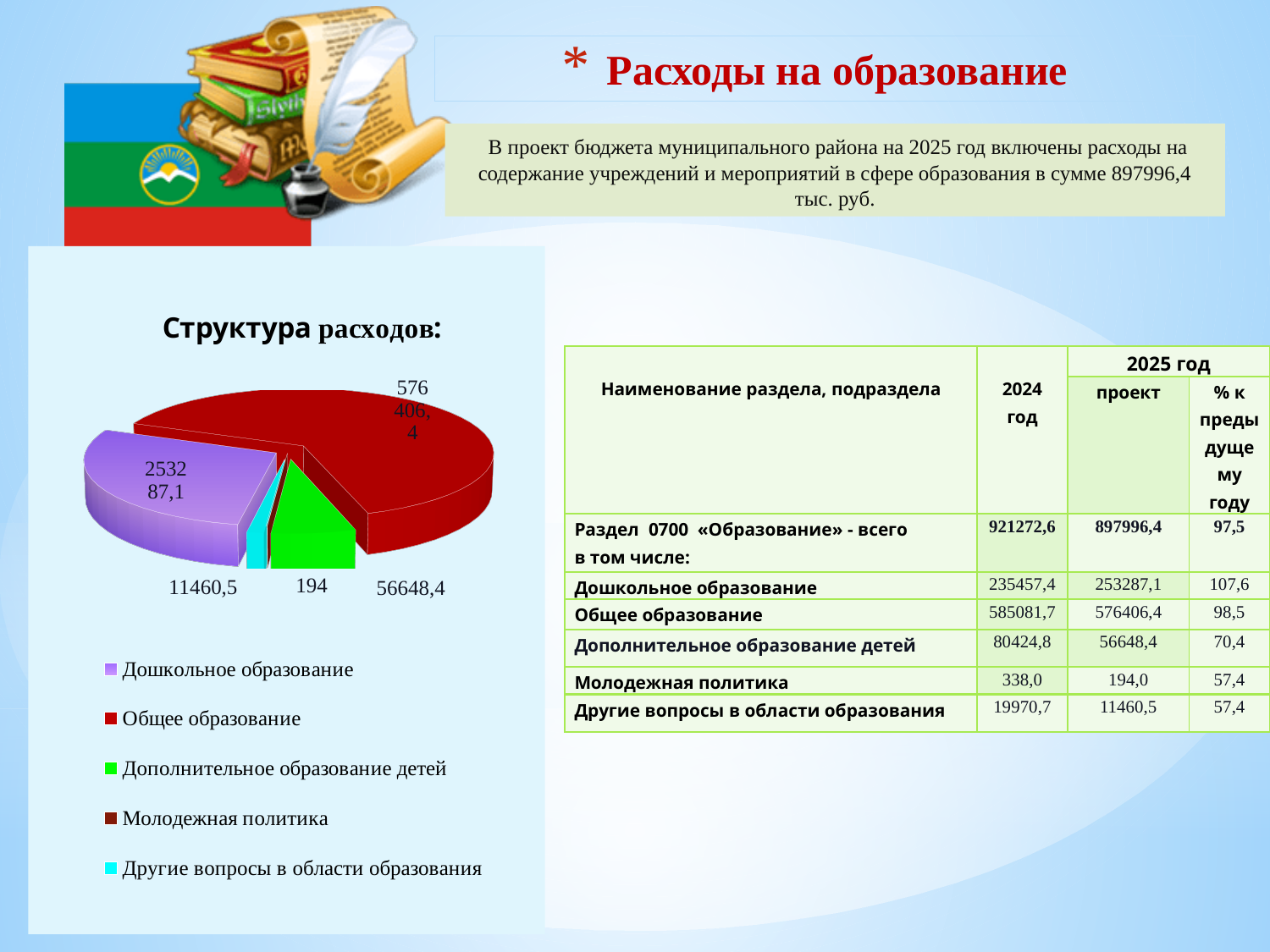
Which category has the largest slice in the "Структура расходов" pie chart? Общее образование In the "Структура расходов" pie chart, what colour is the slice for Дошкольное образование? purple How many slices does the "Структура расходов" pie chart have? 5 In the "Структура расходов" pie chart, what is the value labelled for Молодежная политика? 194 In the "Структура расходов" pie chart, what is the value labelled for Дошкольное образование? 253287,1 In the "Структура расходов" pie chart, what is the difference between the values for Дополнительное образование детей and Другие вопросы в области образования? 45187,9 Which category has the smallest slice in the "Структура расходов" pie chart? Молодежная политика In the "Структура расходов" pie chart, which is larger: Дошкольное образование or Дополнительное образование детей? Дошкольное образование In the "Структура расходов" pie chart, what is the value labelled for Дополнительное образование детей? 56648,4 How many categories does the legend of the "Структура расходов" pie chart list? 5 In the "Структура расходов" pie chart, what is the value labelled for Другие вопросы в области образования? 11460,5 What kind of chart is shown under the title "Структура расходов"? pie chart